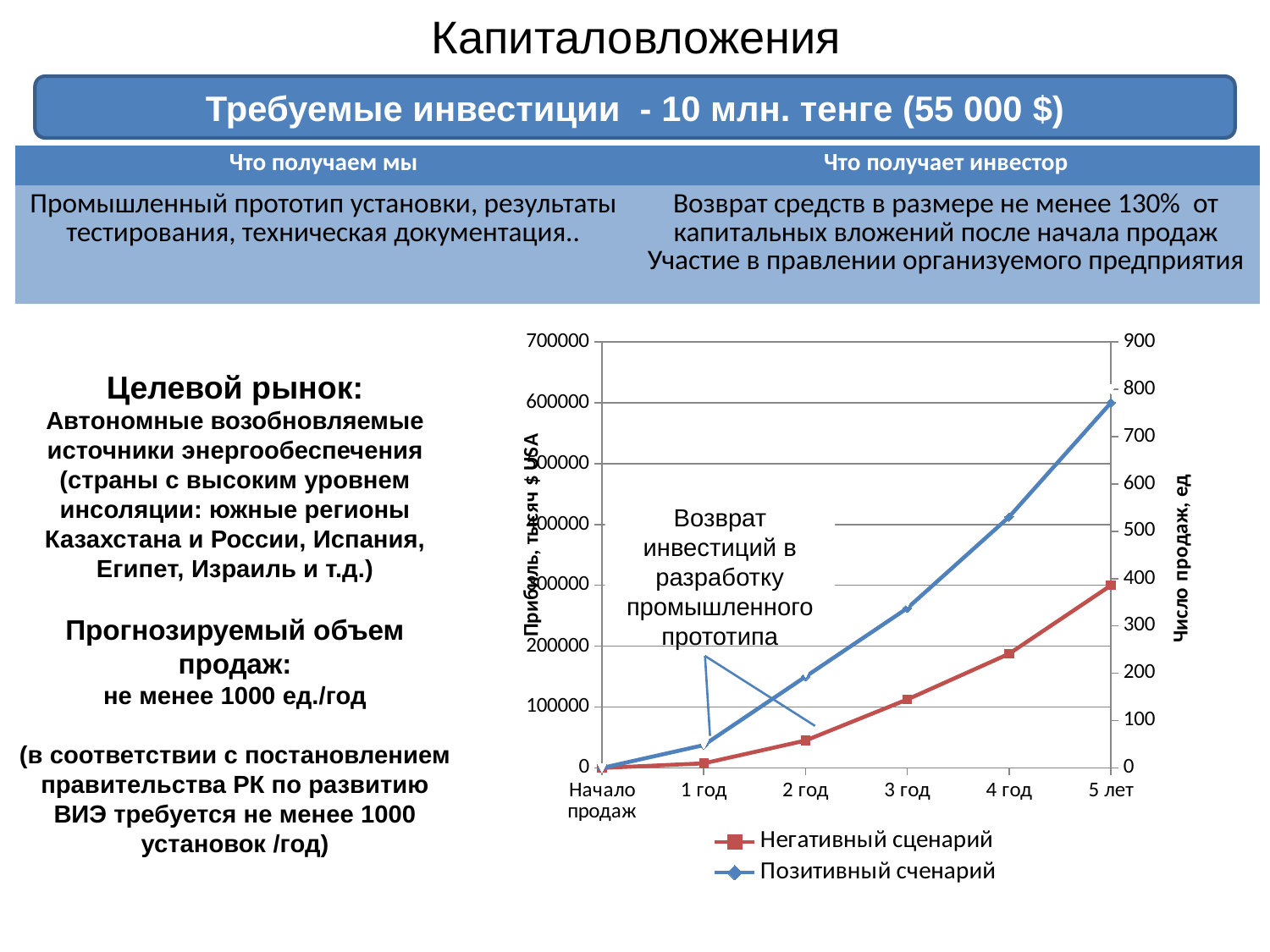
Do the values of the Позитивный сченарий series rise or fall from Начало продаж to 5 лет? rise On the left axis, is the value for Позитивный сченарий at 5 лет greater or less than 500000? greater How many series does the chart legend list? 2 How many points are plotted along the x axis of the chart? 6 What kind of chart is shown on the slide? line chart On the left axis, is the value for Негативный сценарий at 2 год greater or less than 100000? less At which x-axis category is the Негативный сценарий series lowest? Начало продаж At which x-axis category does the Позитивный сченарий series reach its highest value? 5 лет Which series has the higher value at 5 лет, Негативный сценарий or Позитивный сченарий? Позитивный сченарий What is the title of the left vertical axis of the chart? Прибыль, тысяч $ USA On the left axis, is the value for Позитивный сченарий at 3 год greater or less than 200000? greater